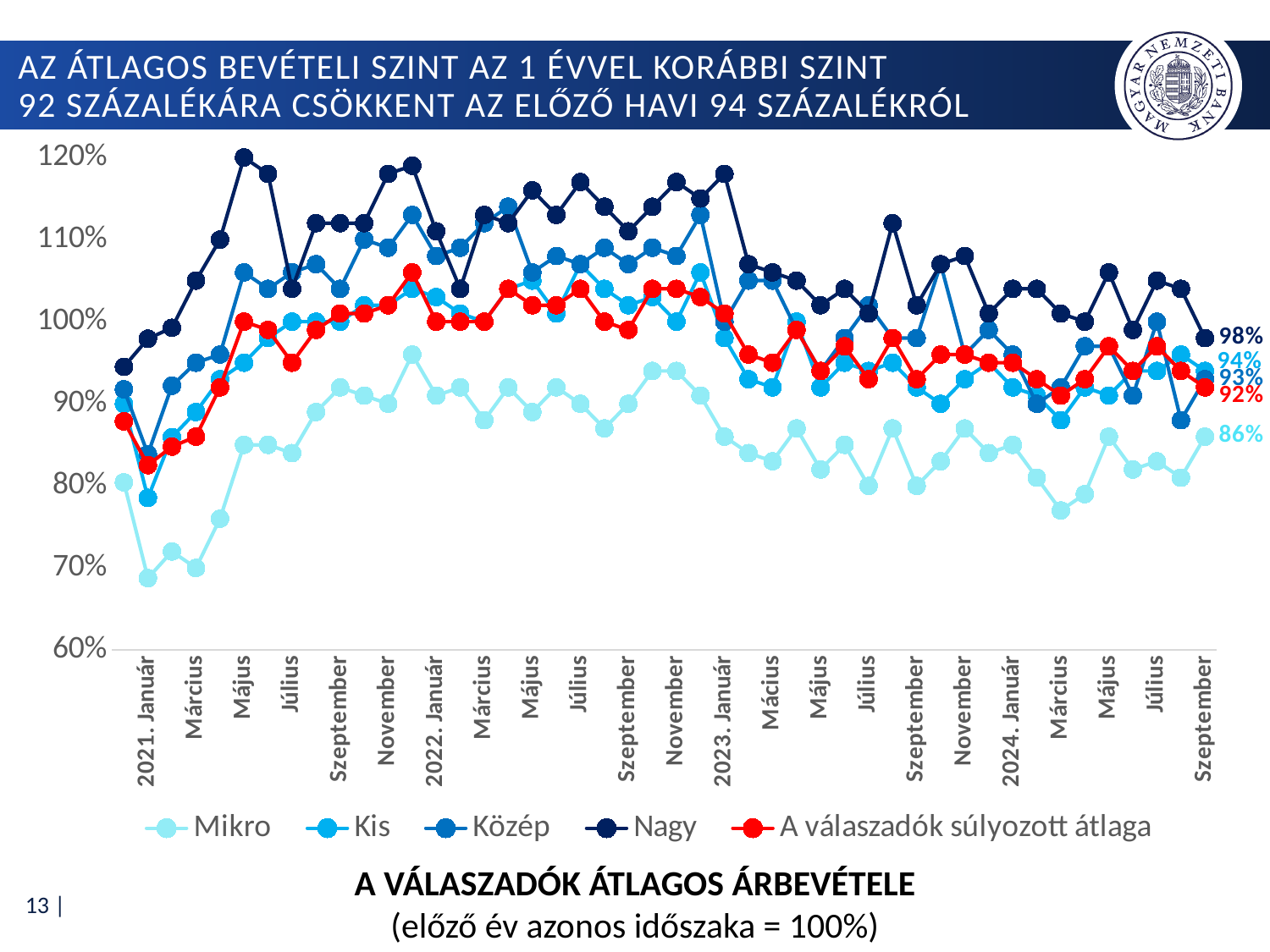
How many series does the legend list? 5 What is the value of 'A válaszadók súlyozott átlaga' at the last point (2024 Szeptember)? 92% Is the value for Mikro in 2021 Március greater or less than 80%? less Is the value for Nagy in 2021 Május greater or less than 110%? greater What is the title of the chart shown below the legend? A válaszadók átlagos árbevétele What kind of chart is shown on the slide? line chart Which series has the highest value at the last point (2024 Szeptember)? Nagy What is the value for Mikro at the last point (2024 Szeptember)? 86% What is the value for Nagy at the last point (2024 Szeptember)? 98% At the last point (2024 Szeptember), which is larger: the Nagy value or the Mikro value? Nagy What is the difference between the Nagy and Mikro values at the last point (2024 Szeptember)? 12 percentage points Which series has the lowest value at the last point (2024 Szeptember)? Mikro